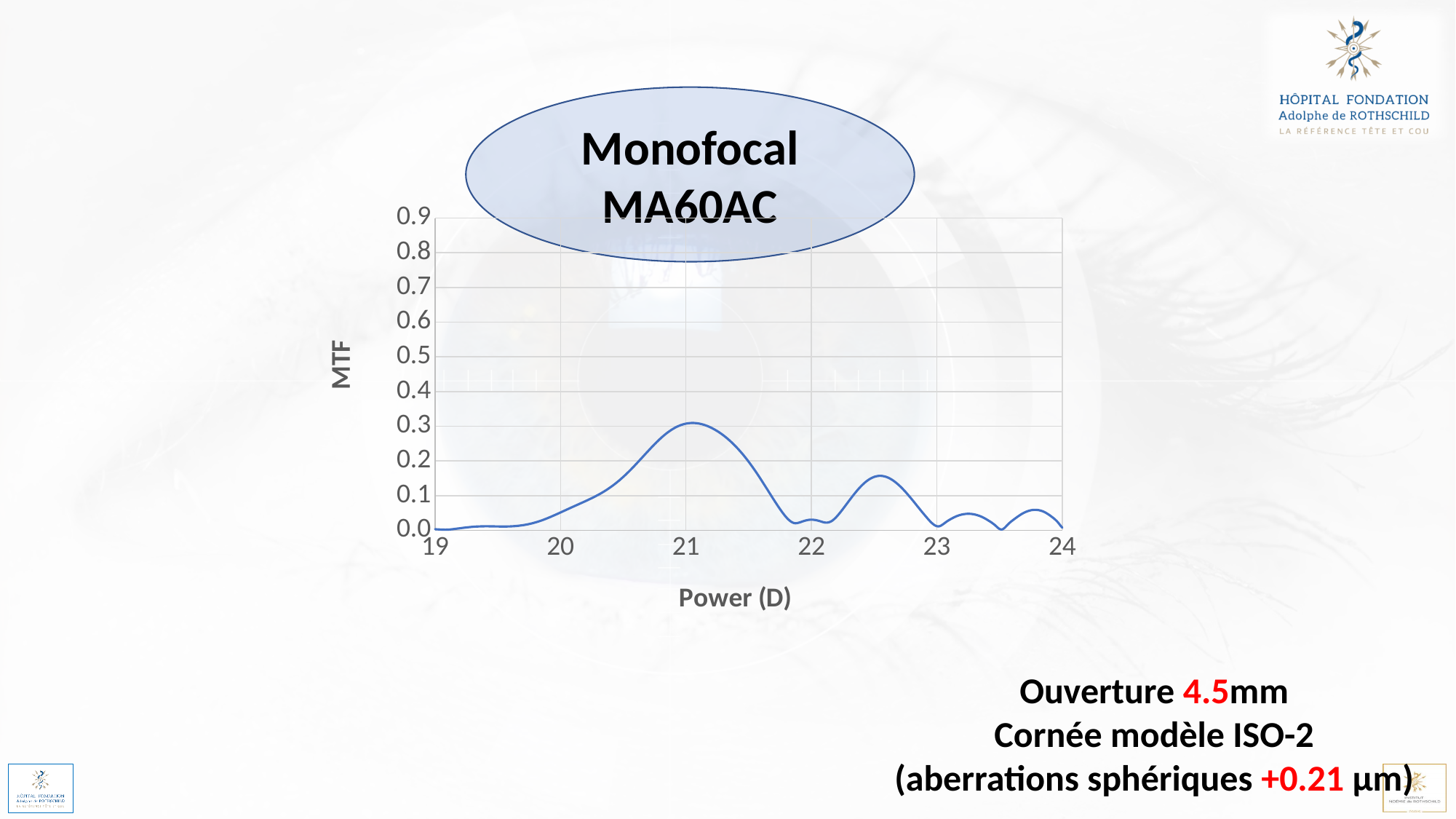
What is the label of the x axis of the chart? Power (D) Is the MTF value at 19 D greater or less than 0.1? less How many lines (series) are plotted on the chart? 1 Is the MTF value at 21 D greater or less than 0.2? greater What is the title shown above the chart? Monofocal MA60AC Does the MTF curve rise or fall between 19 D and 21 D? rise Is the peak MTF value of the curve greater or less than 0.4? less Does the MTF curve rise or fall between 21 D and 22 D? fall Is the MTF value at 21 D larger or smaller than the MTF value at 22 D? larger What kind of chart is shown on the slide? line chart